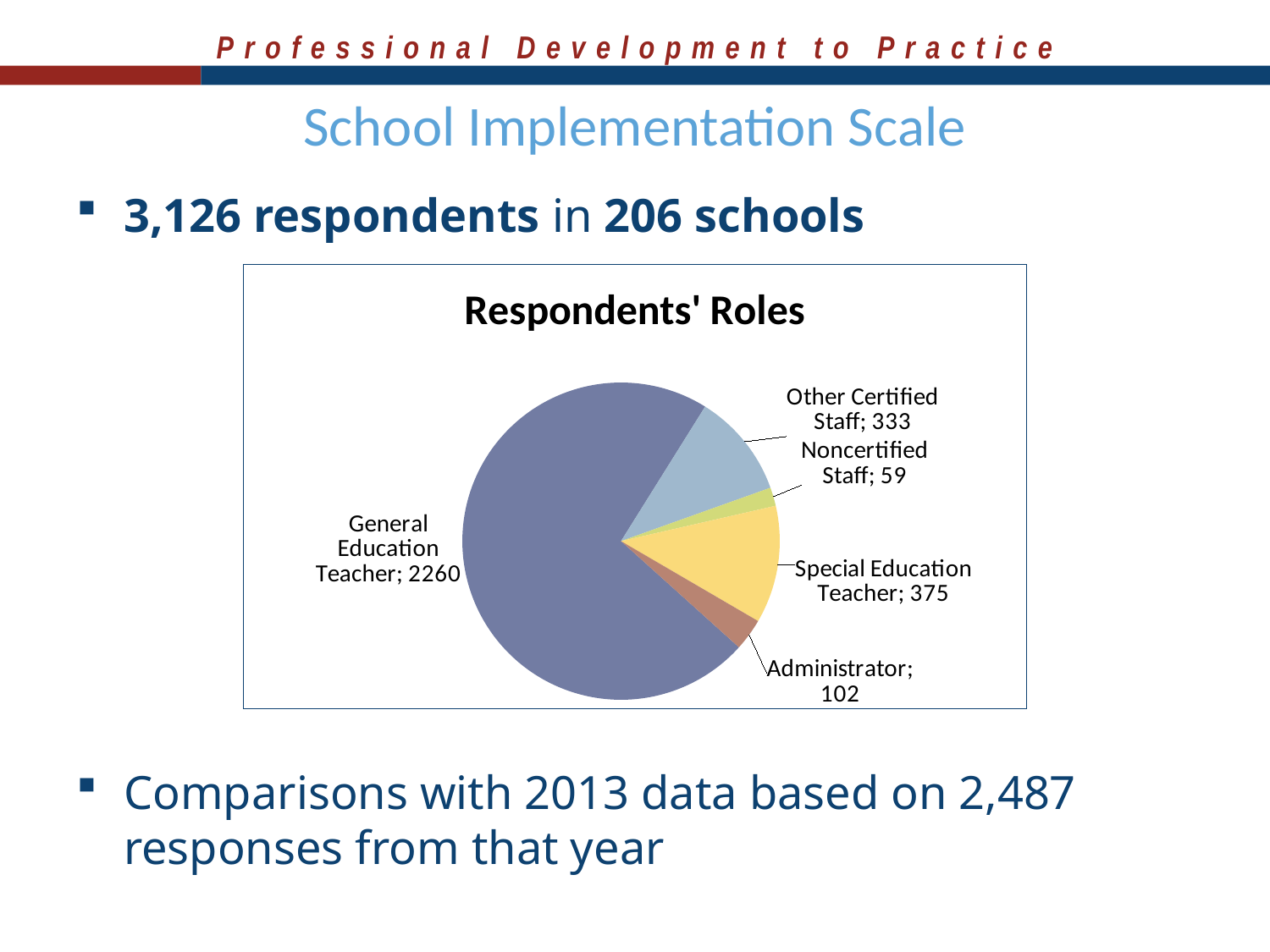
How many respondents were General Education Teachers according to the chart? 2260 Which is larger, the value for Special Education Teacher or for Other Certified Staff? Special Education Teacher Which role has the smallest slice of the pie? Noncertified Staff What value is shown for Noncertified Staff? 59 What is the title of the chart? Respondents' Roles What value is shown for Administrator? 102 How many respondents were Special Education Teachers? 375 How many role categories are shown in the pie chart? 5 What type of chart is shown on the slide? Pie chart Which role has the largest slice of the pie? General Education Teacher What is the difference between the Administrator value and the Noncertified Staff value? 43 What is the difference between the Special Education Teacher value and the Other Certified Staff value? 42